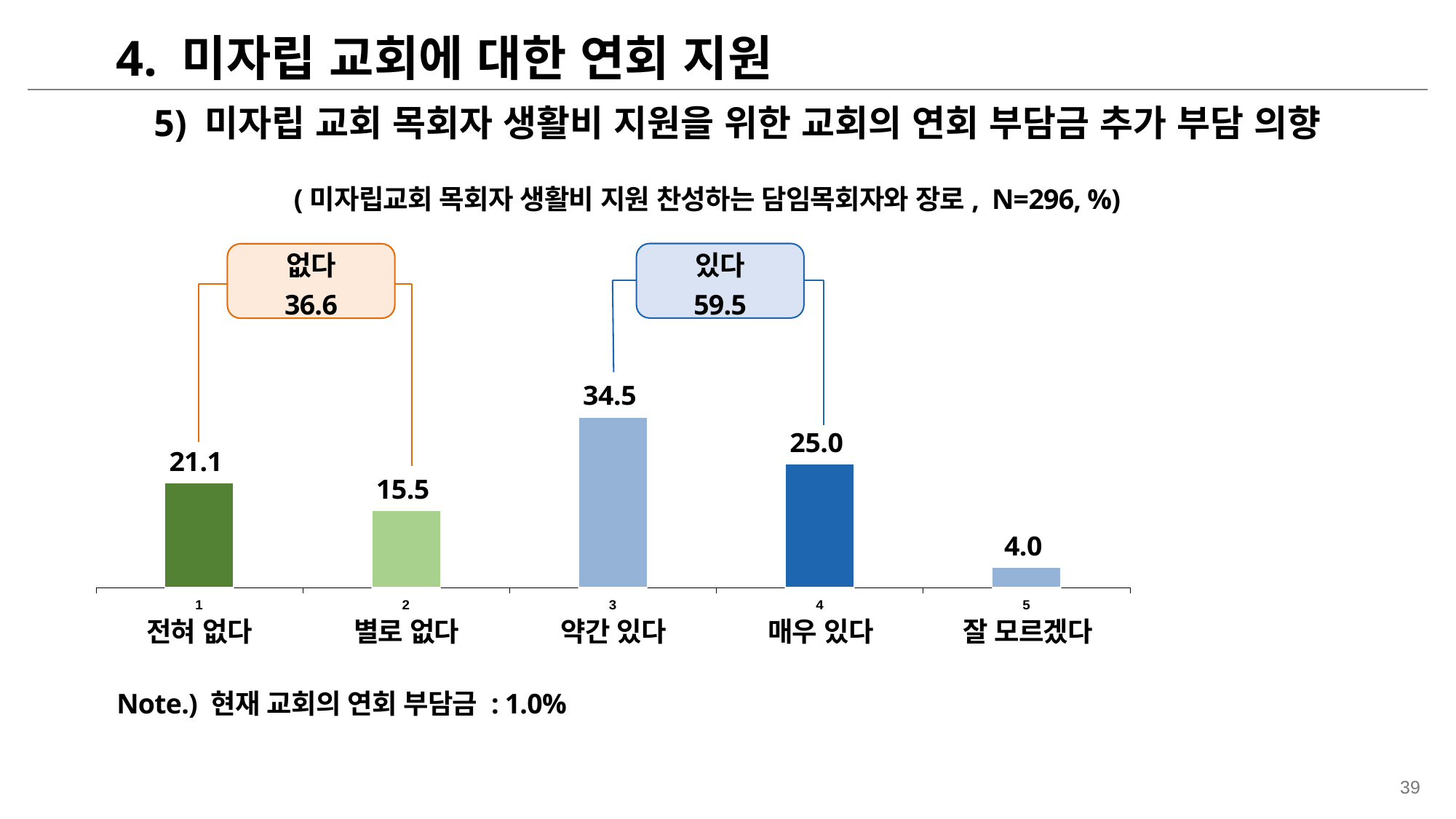
Which is larger, the value for 전혀 없다 or the value for 별로 없다? 전혀 없다 How many categories are shown on the x axis? 5 What is the difference between the values for 약간 있다 and 매우 있다? 9.5 What combined value is shown in the box labelled 있다 above the chart? 59.5 What is the value for 별로 없다? 15.5 What is the value for 약간 있다? 34.5 What is the value for 잘 모르겠다? 4.0 What kind of chart is shown on the slide? bar chart Which category has the highest value? 약간 있다 What is the value for 매우 있다? 25.0 Which category has the lowest value? 잘 모르겠다 What is the value for 전혀 없다? 21.1